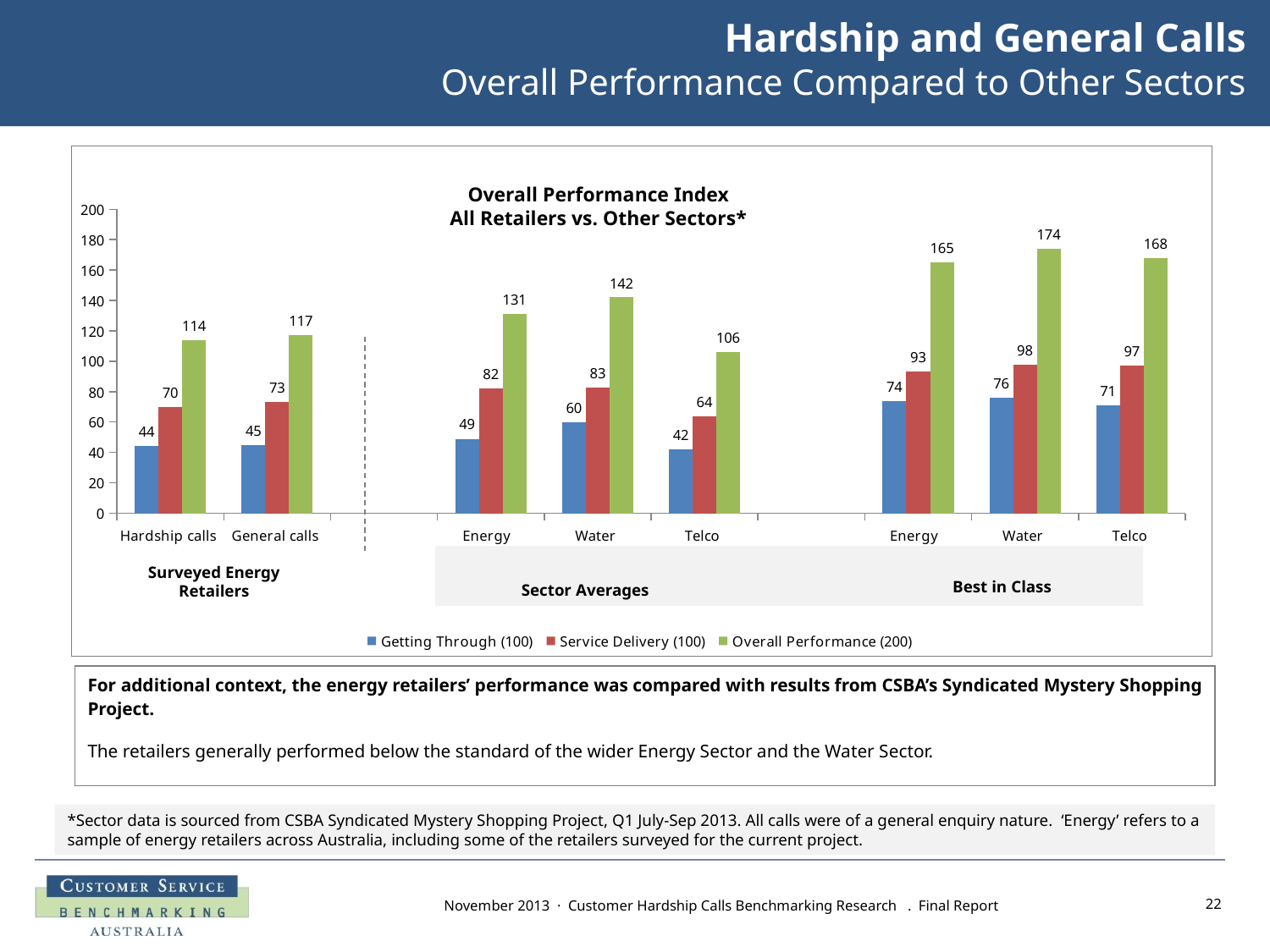
What is the title of the chart? Overall Performance Index All Retailers vs. Other Sectors* What kind of chart is shown on the slide? Bar chart Which is larger: the Service Delivery (100) value for Energy in the Sector Averages group or for Energy in the Best in Class group? Energy in the Best in Class group Which series is shown in green in the legend? Overall Performance (200) What is the Service Delivery (100) value for Water in the Sector Averages group? 83 What is the difference between the Overall Performance (200) values for General calls and Hardship calls? 3 Which category has the highest Overall Performance (200) value? Water (Best in Class) What is the Overall Performance (200) value for Telco in the Best in Class group? 168 Which category has the lowest Getting Through (100) value? Telco (Sector Averages) What is the Overall Performance (200) value for Hardship calls? 114 How many series does the legend list? 3 What is the Getting Through (100) value for General calls? 45